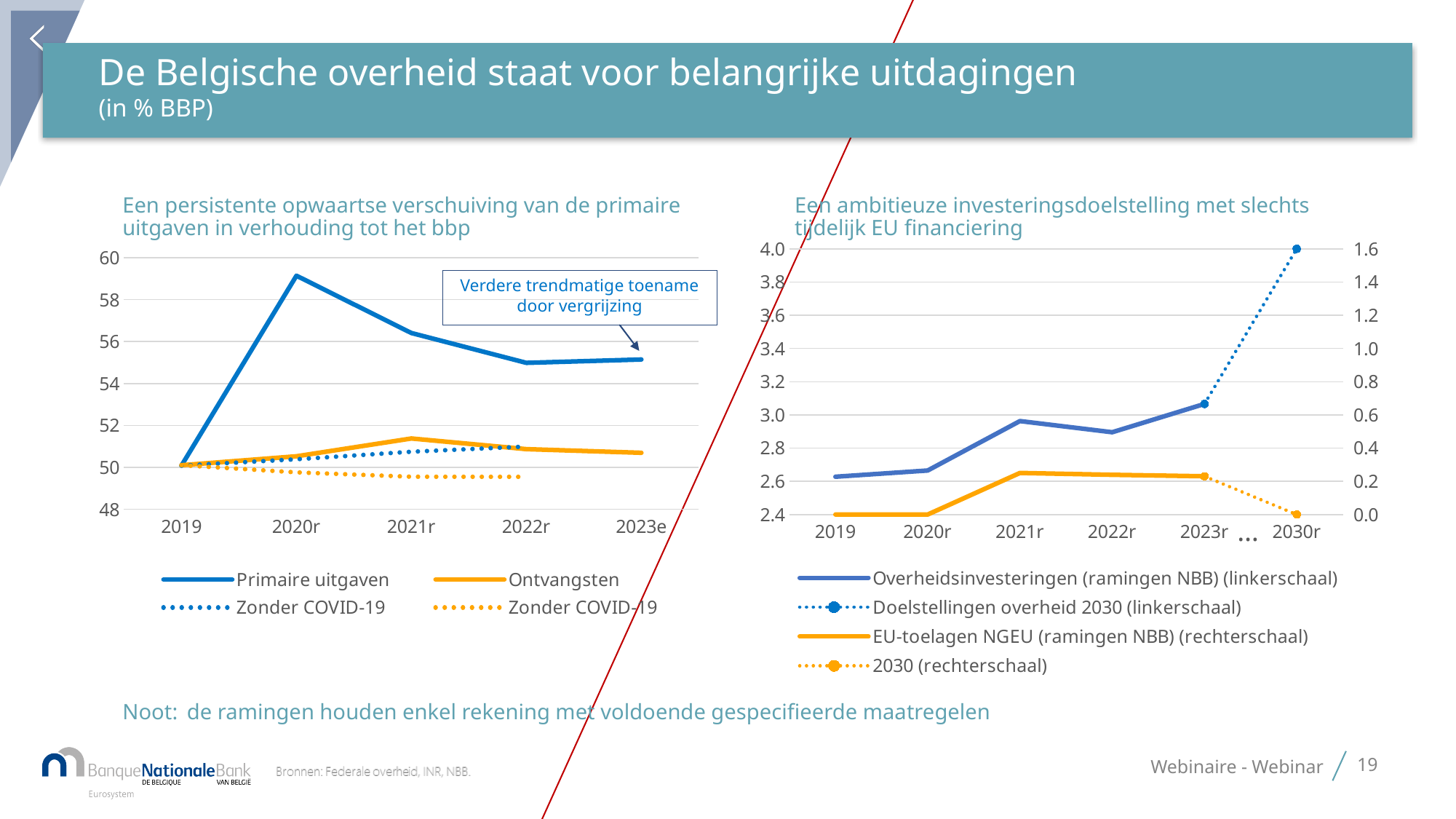
How many years are shown on the x axis of the left chart? 5 In the right chart, is the value for 'Overheidsinvesteringen (ramingen NBB) (linkerschaal)' in 2019 greater or less than 2.8? less In the right chart, 'Een ambitieuze investeringsdoelstelling met slechts tijdelijk EU financiering', what is the value of 'Doelstellingen overheid 2030 (linkerschaal)' at 2030r? 4.0 How many series does the legend of the right chart list? 4 In the left chart, in which year is 'Primaire uitgaven' highest? 2020r In the left chart, is the value for 'Primaire uitgaven' in 2023e greater or less than 56? less In the right chart, what is the value of '2030 (rechterschaal)' at 2030r? 0.0 How many series does the legend of the left chart list? 4 In the left chart, which is larger in 2021r: 'Primaire uitgaven' or 'Ontvangsten'? Primaire uitgaven What kind of chart is the left chart, 'Een persistente opwaartse verschuiving van de primaire uitgaven in verhouding tot het bbp'? Line chart In the right chart, does 'Overheidsinvesteringen (ramingen NBB) (linkerschaal)' rise or fall from 2019 to 2021r? rise In the left chart, is the value for 'Primaire uitgaven' in 2020r greater or less than 58? greater